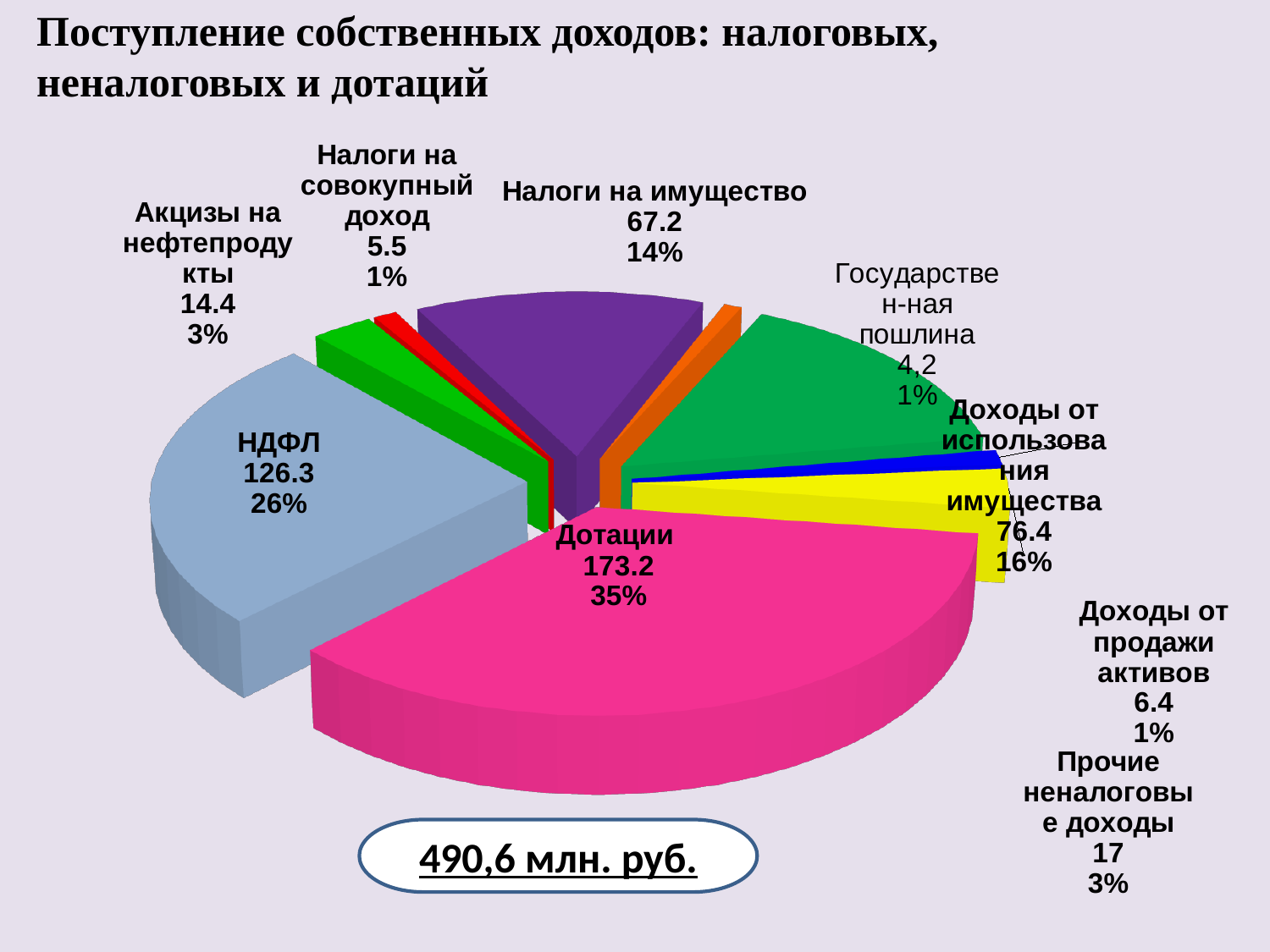
What is the value for НДФЛ on the pie chart? 126.3 Which is larger: Налоги на имущество or Доходы от использования имущества? Доходы от использования имущества What is the value for Налоги на имущество? 67.2 What share of the pie does НДФЛ represent? 26% What share of the pie does Доходы от использования имущества represent? 16% What is the difference between the values for Дотации and НДФЛ? 46.9 What is the value for Акцизы на нефтепродукты? 14.4 How many categories are shown on the pie chart? 9 What is the value for Дотации on the pie chart? 173.2 What type of chart is shown on the slide? Pie chart Which category has the largest slice of the pie? Дотации Which category has the smallest value on the pie chart? Государственная пошлина